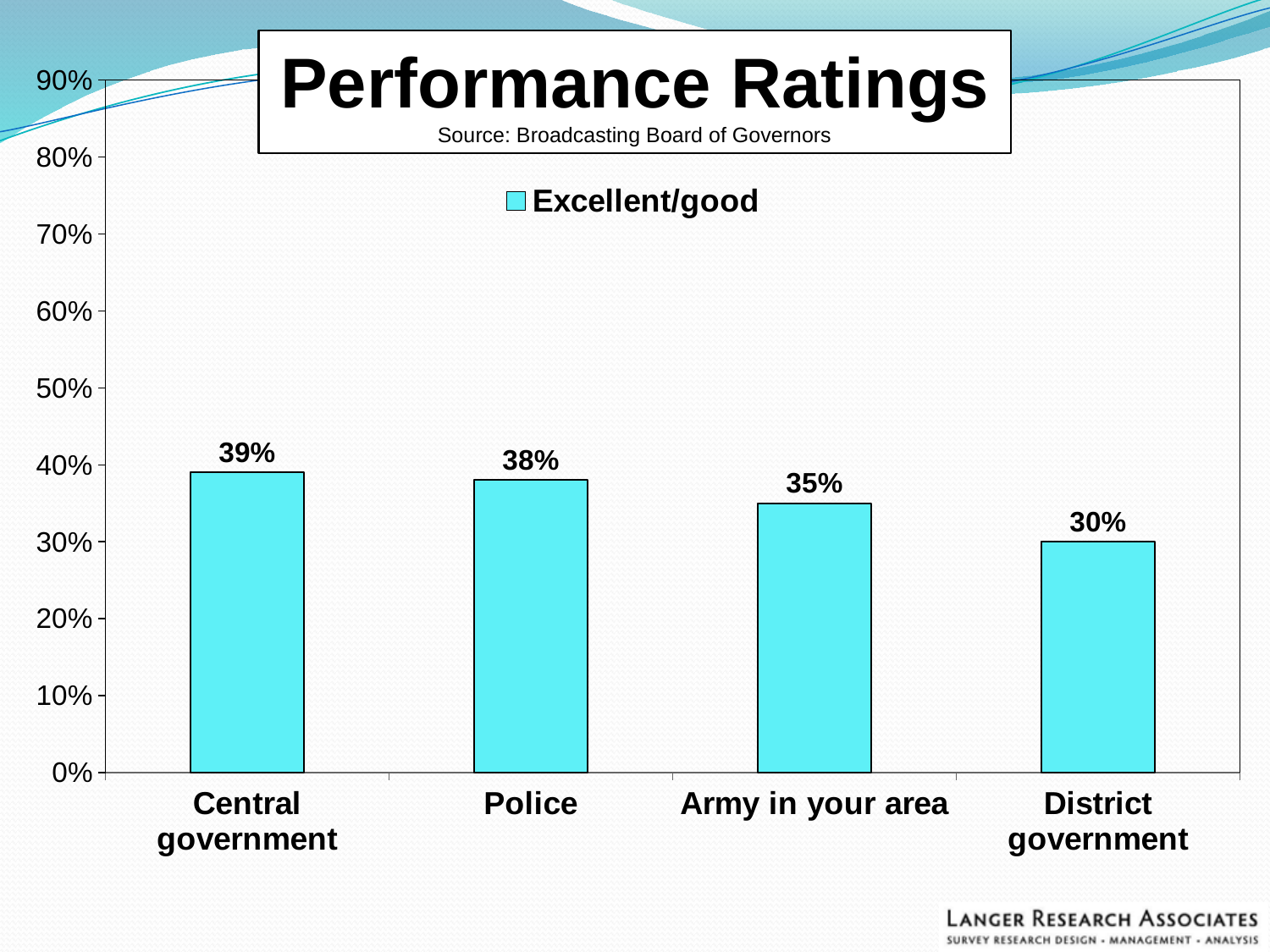
What is the Excellent/good rating for Police? 38% What is the difference between the Excellent/good ratings for Central government and District government? 9% What kind of chart is shown on the slide? Bar chart Which category has the lowest Excellent/good rating? District government What is the title of the chart? Performance Ratings What is the Excellent/good rating for Army in your area? 35% How many categories are shown on the chart? 4 What is the Excellent/good rating for District government? 30% Which has a higher Excellent/good rating, Army in your area or District government? Army in your area What is the difference between the Excellent/good ratings for Police and Army in your area? 3% Which category has the highest Excellent/good rating? Central government What is the Excellent/good rating for Central government? 39%